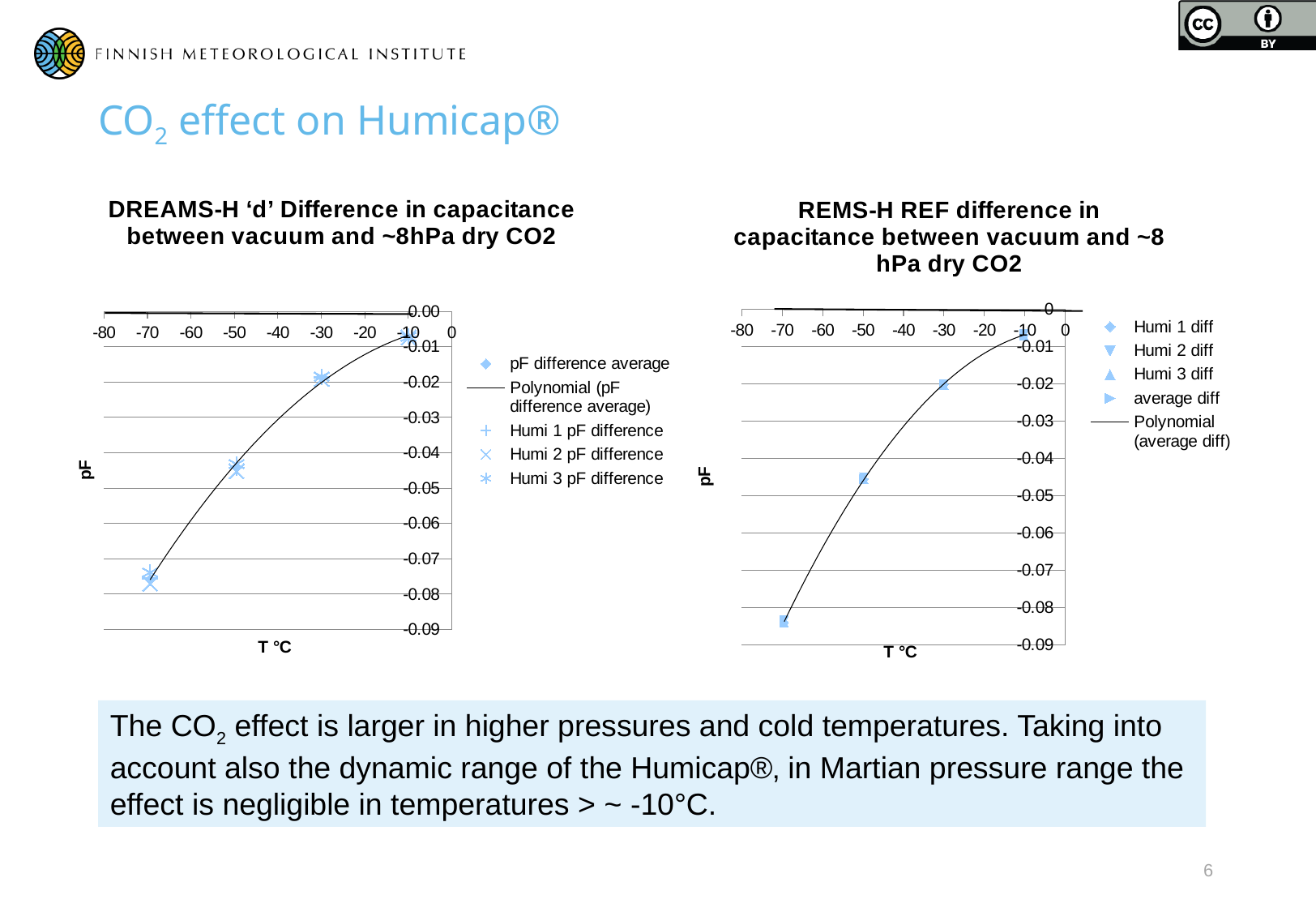
In the right chart (REMS-H REF), is the average diff at -70 °C greater or less than -0.08? less In the left chart (DREAMS-H 'd'), at how many temperatures are data points plotted? 4 In the left chart (DREAMS-H 'd'), which temperature has the lowest (most negative) pF difference? -70 What is the label of the vertical axis on the right chart (REMS-H REF)? pF In the left chart (DREAMS-H 'd'), is the pF difference at -70 °C greater or less than -0.07? less How many entries does the legend of the right chart (REMS-H REF) list? 5 What is the label of the horizontal axis on the left chart (DREAMS-H 'd')? T °C In the right chart (REMS-H REF), do the plotted values rise or fall as temperature increases from -70 °C toward 0 °C? rise How many entries does the legend of the left chart (DREAMS-H 'd') list? 5 In the right chart (REMS-H REF), is the average diff at -50 °C greater or less than -0.05? greater What kind of chart is the DREAMS-H 'd' chart on the left? scatter chart